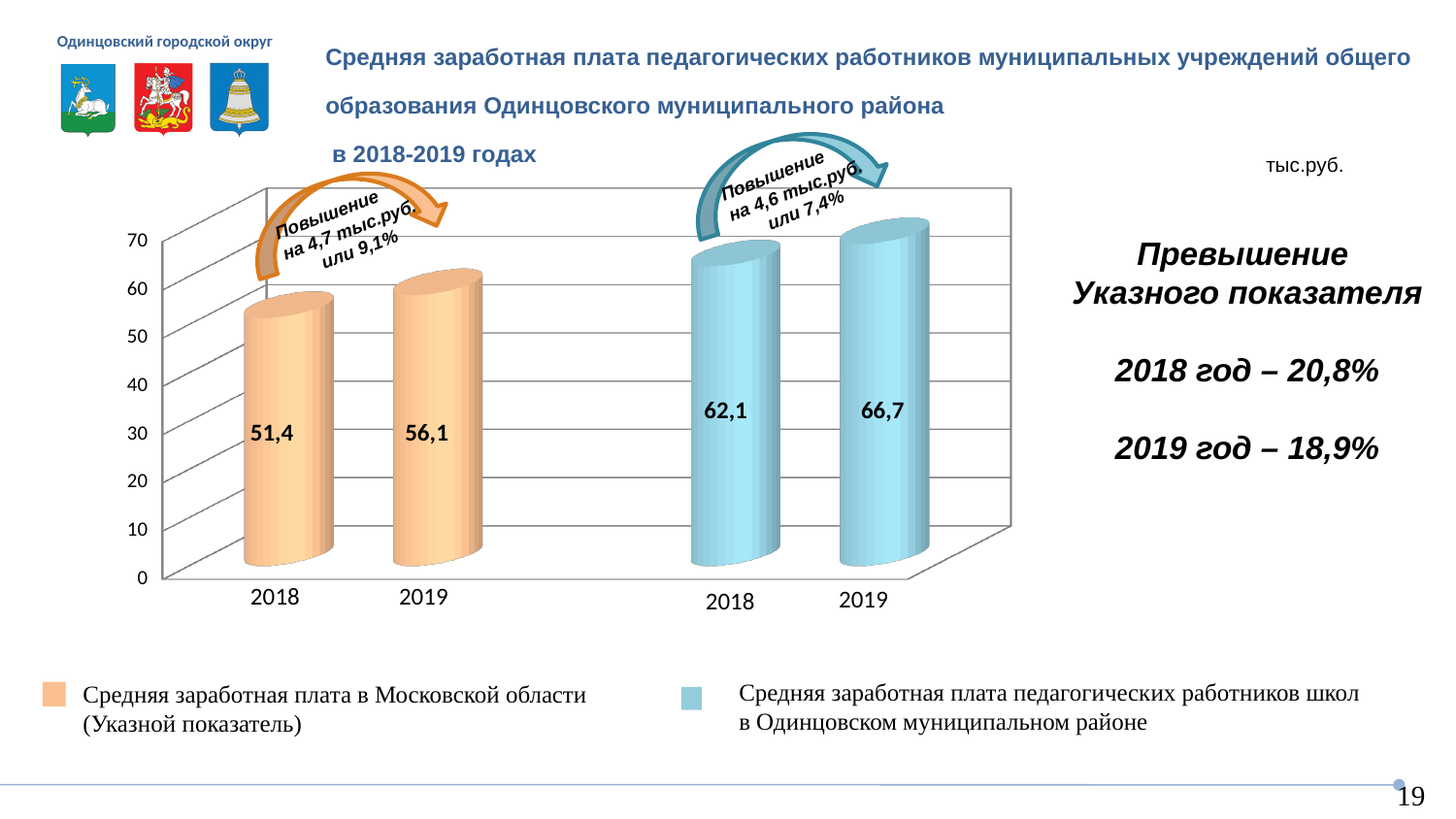
What is the difference between the Odintsovo teachers' salary and the Moscow region average in 2019? 10,6 In what units are the values on the chart expressed? тыс.руб. Which bar shows the lowest value on the chart? Moscow region, 2018 (51,4) Which bar shows the highest value on the chart? Odintsovo teachers, 2019 (66,7) Is the Odintsovo teachers' salary for 2018 greater or less than 60? greater What is the average salary in the Moscow region (Указной показатель) for 2019? 56,1 By how much did the Moscow region average salary increase from 2018 to 2019? 4,7 What type of chart is shown on the slide? bar chart What is the average salary in the Moscow region (Указной показатель) for 2018? 51,4 Which is larger in 2018: the Odintsovo teachers' salary or the Moscow region average? Odintsovo teachers' salary What is the average salary of teachers in the Odintsovo municipal district for 2019? 66,7 How many bars are plotted on the chart? 4